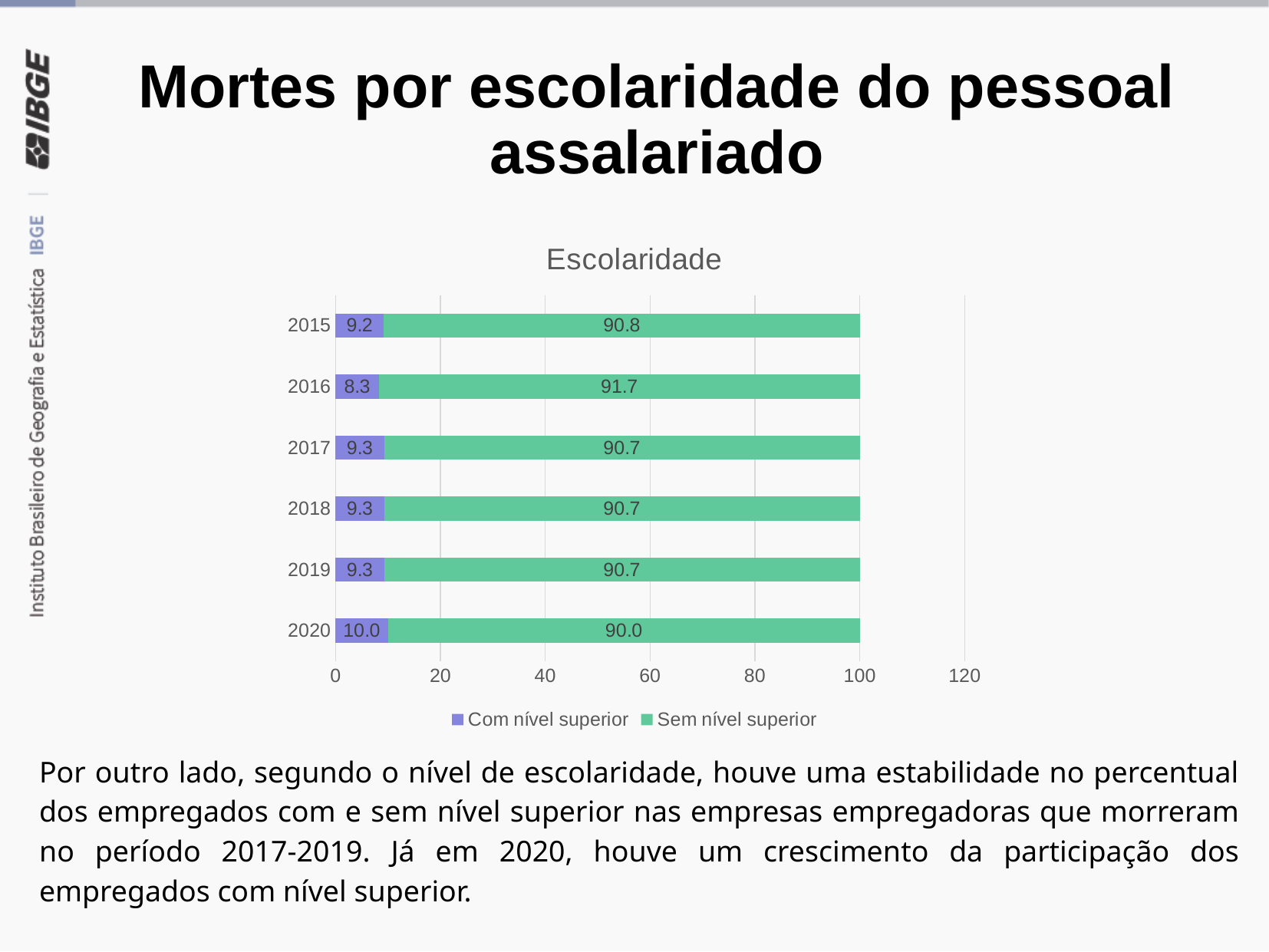
What is the total of the stacked bar for 2017? 100.0 What is the value for "Com nível superior" in 2020? 10.0 Is the "Com nível superior" value for 2016 larger or smaller than the value for 2020? smaller Which year has the highest value for "Sem nível superior"? 2016 Which year has the lowest value for "Com nível superior"? 2016 What is the value for "Com nível superior" in 2015? 9.2 How many series does the legend list? 2 What type of chart is shown on the slide? Stacked bar chart What is the difference between the "Sem nível superior" value and the "Com nível superior" value in 2020? 80.0 How many years are shown on the chart? 6 What is the value for "Sem nível superior" in 2016? 91.7 Which year has the highest value for "Com nível superior"? 2020